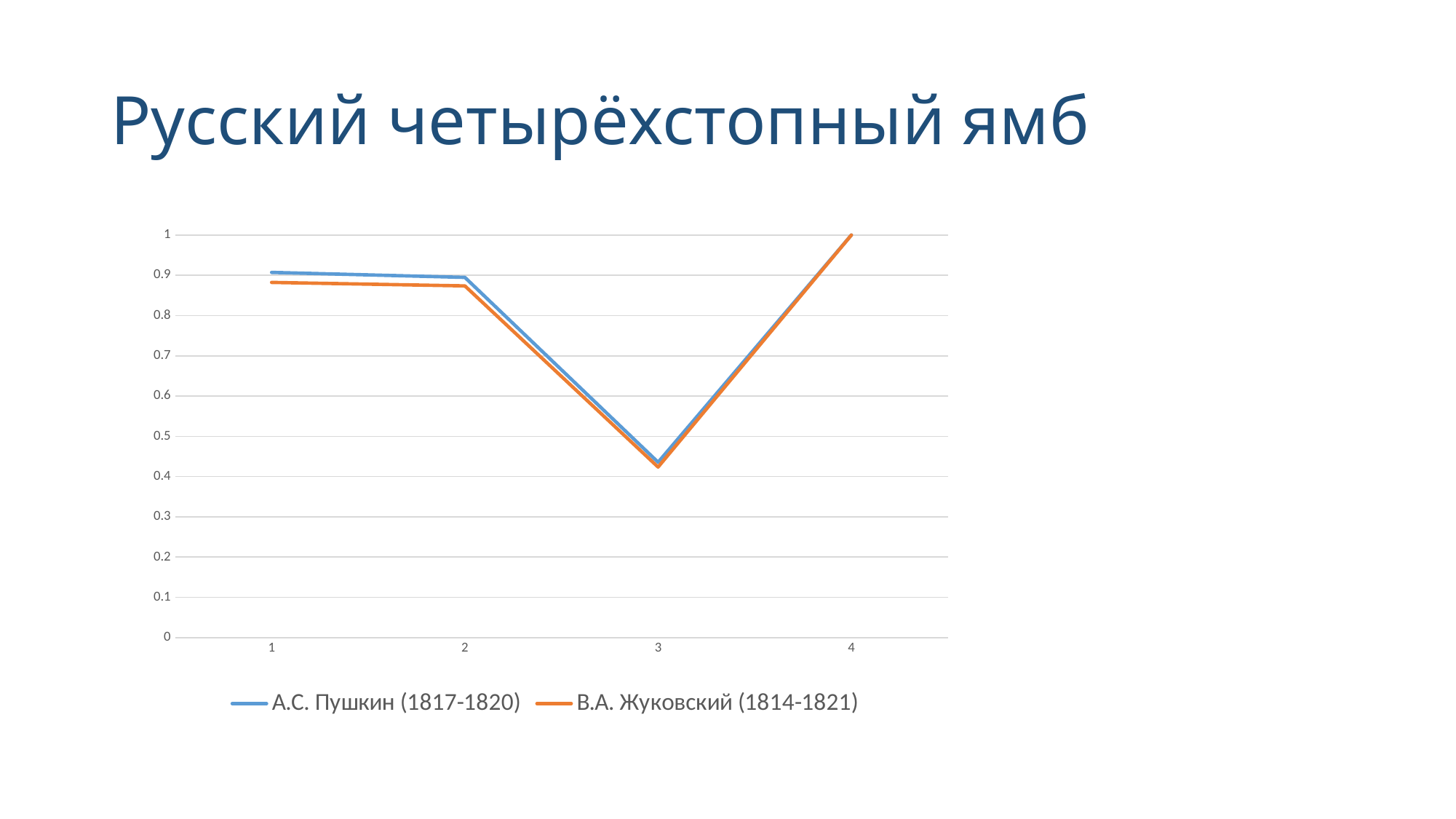
What is the value for В.А. Жуковский (1814-1821) at position 4? 1 At which x-axis position is the value for А.С. Пушкин (1817-1820) lowest? 3 How many points are plotted along the x axis for each series? 4 Do the values for А.С. Пушкин (1817-1820) rise or fall from position 2 to position 3? fall Which series has the higher value at position 1, А.С. Пушкин (1817-1820) or В.А. Жуковский (1814-1821)? А.С. Пушкин (1817-1820) Is the value for В.А. Жуковский (1814-1821) at position 3 greater or less than 0.5? less How many series does the legend list? 2 What is the title of the slide containing the chart? Русский четырёхстопный ямб Is the value for А.С. Пушкин (1817-1820) at position 1 greater or less than 0.8? greater What kind of chart is shown on the slide? line chart At which x-axis position is the value for В.А. Жуковский (1814-1821) highest? 4 What is the value for А.С. Пушкин (1817-1820) at position 4? 1